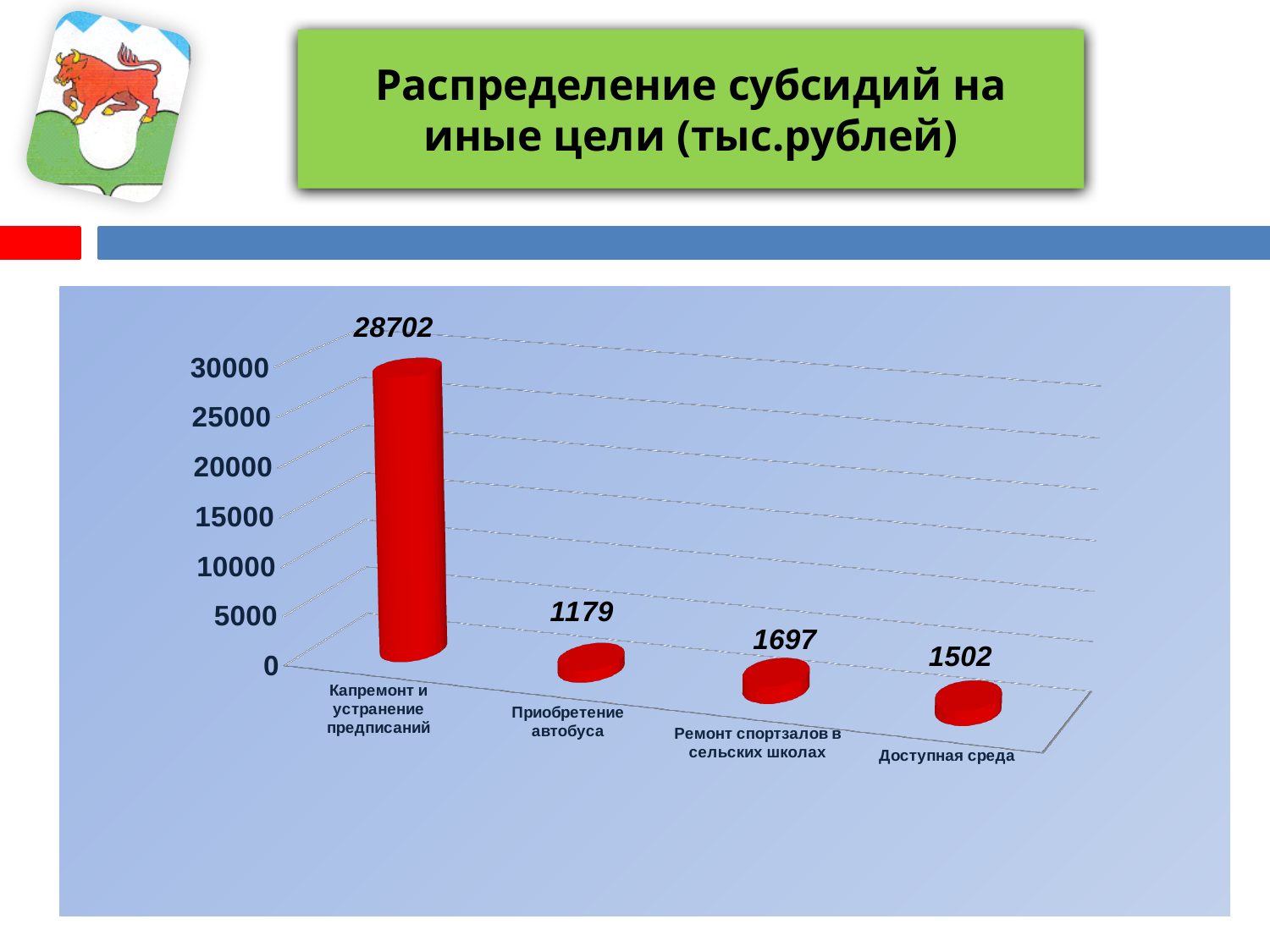
Which is larger, the value for Ремонт спортзалов в сельских школах or the value for Доступная среда? Ремонт спортзалов в сельских школах Which category has the highest value? Капремонт и устранение предписаний What is the difference between the values for Ремонт спортзалов в сельских школах and Доступная среда? 195 What is the value for Приобретение автобуса? 1179 What kind of chart is shown on the slide? Bar chart What is the value for Капремонт и устранение предписаний? 28702 What is the value for Ремонт спортзалов в сельских школах? 1697 What is the difference between the values for Капремонт и устранение предписаний and Приобретение автобуса? 27523 Which category has the lowest value? Приобретение автобуса What is the title of the slide? Распределение субсидий на иные цели (тыс.рублей) What is the value for Доступная среда? 1502 How many categories are shown in the chart? 4